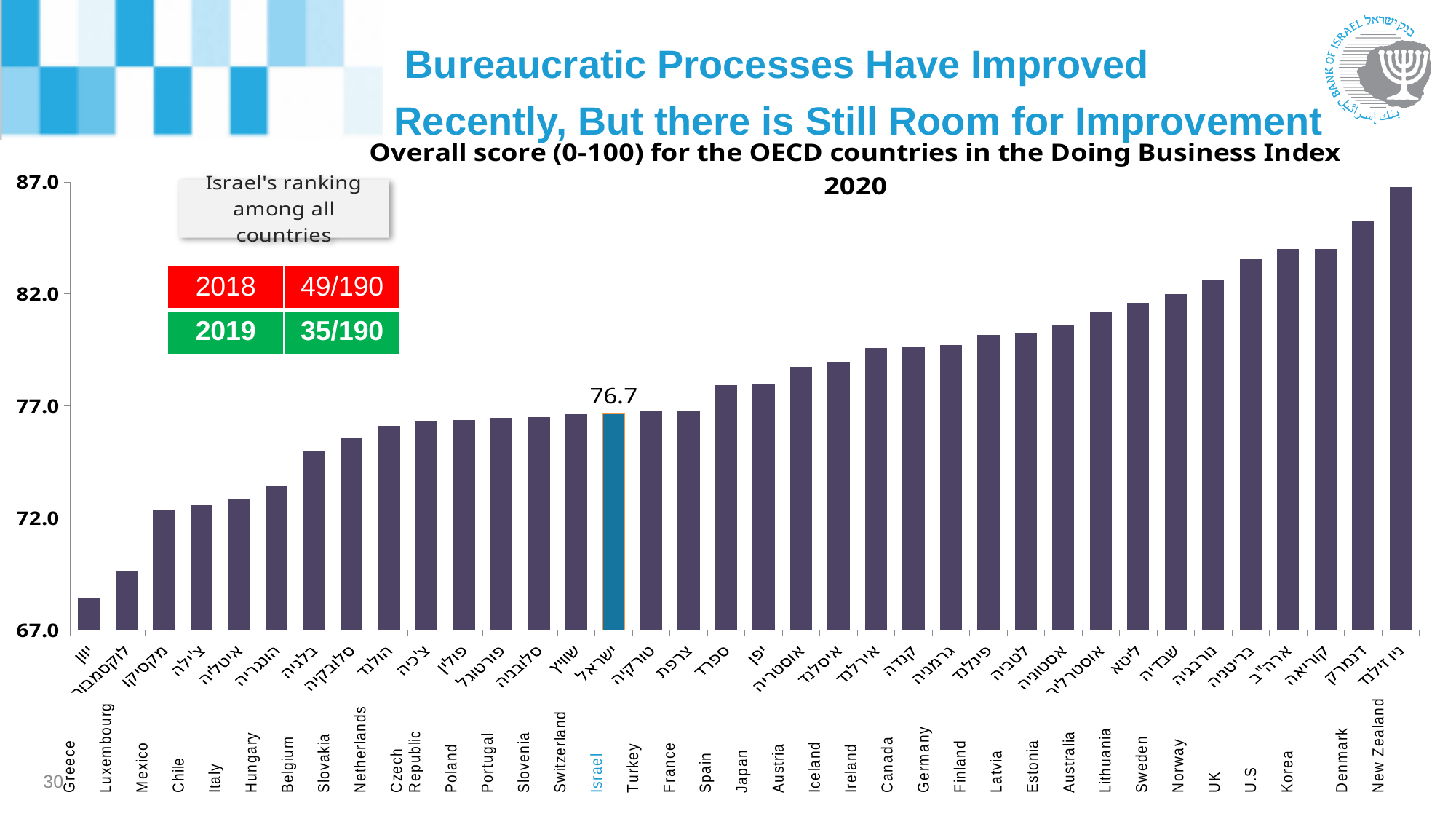
Which country has the highest overall score? New Zealand Do the values rise or fall moving from left to right along the x axis? Rise Which country has the lowest overall score? Greece Is the value for Greece greater or less than 72.0? less How many countries are shown in the chart? 36 Which country's bar is highlighted in a different colour from the rest? Israel Which has a higher score, Greece or Luxembourg? Luxembourg Which has a higher score, Denmark or Korea? Denmark What kind of chart is shown on the slide? Bar chart What is the value shown for Israel? 76.7 Is the value for Denmark greater or less than 82.0? greater Is the value for Slovakia greater or less than 77.0? less